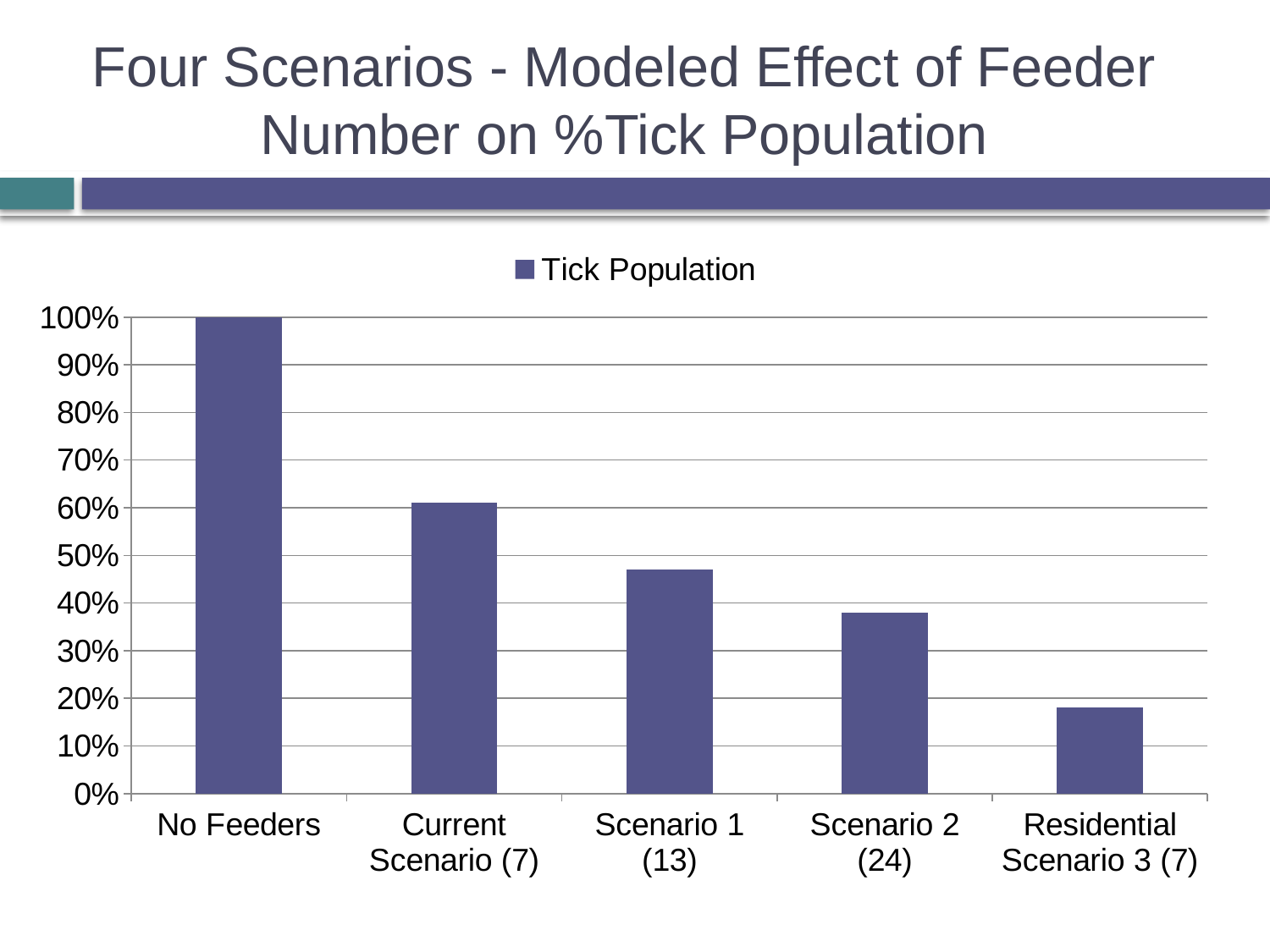
What is the name of the series shown in the chart legend? Tick Population Which category has the highest Tick Population value? No Feeders Which has a larger Tick Population value, Scenario 1 (13) or Scenario 2 (24)? Scenario 1 (13) What is the Tick Population value for No Feeders? 100% What kind of chart is shown on the slide? bar chart Is the value for Scenario 2 (24) greater or less than 30%? greater How many series does the chart legend list? 1 How many categories are shown on the x axis of the chart? 5 Is the value for Current Scenario (7) greater or less than 50%? greater Is the value for Scenario 1 (13) greater or less than 50%? less Which category has the lowest Tick Population value? Residential Scenario 3 (7)